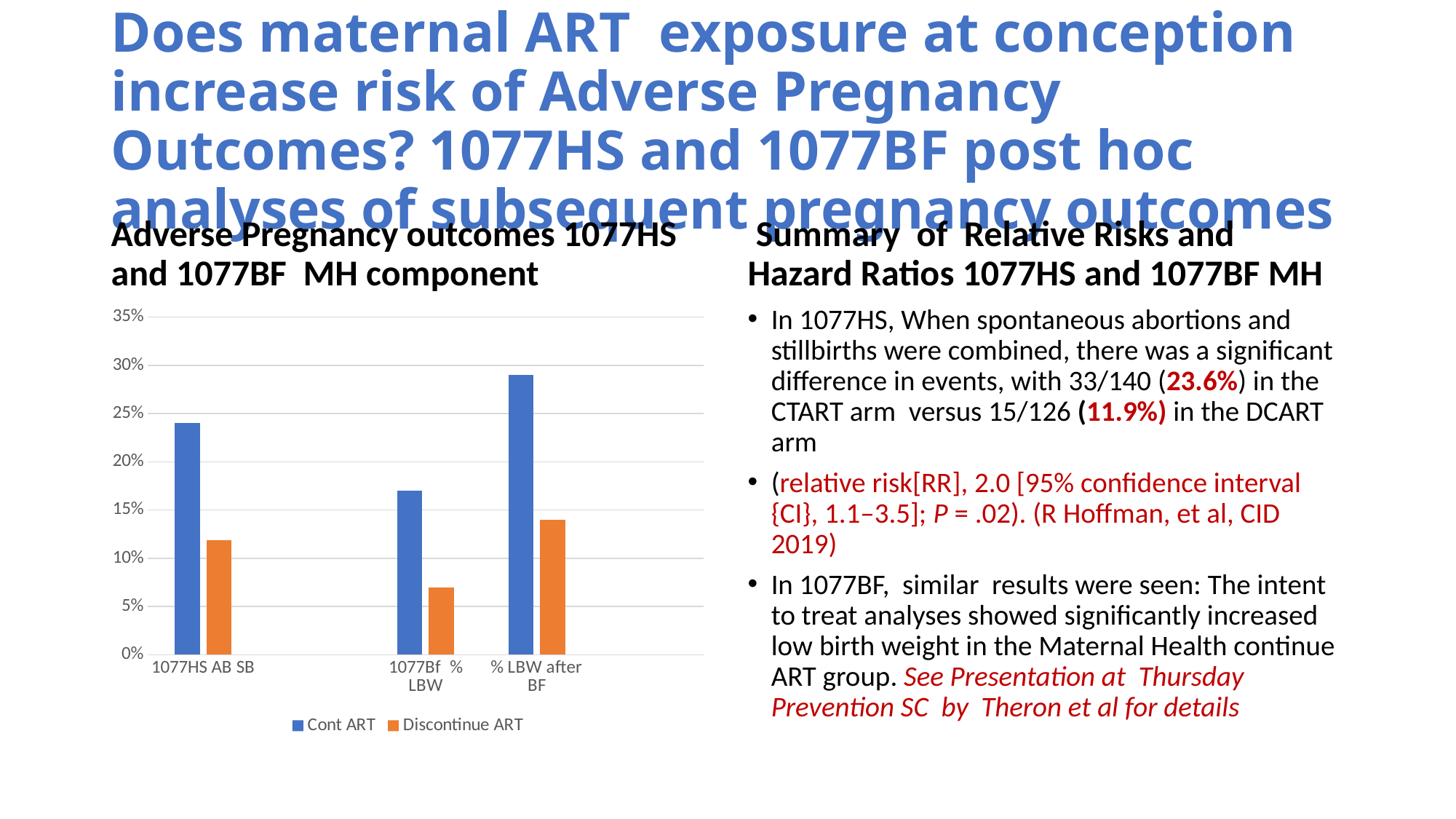
What are the two series named in the chart legend? Cont ART and Discontinue ART What is the title of the chart? Adverse Pregnancy outcomes 1077HS and 1077BF MH component How many series does the chart legend list? 2 Is the Cont ART value for % LBW after BF greater or less than 25%? greater How many categories are shown on the x axis of the chart? 3 For % LBW after BF, which is larger: Cont ART or Discontinue ART? Cont ART Is the Cont ART value for 1077HS AB SB greater or less than 20%? greater What kind of chart is shown on the slide? Bar chart For which category is the Discontinue ART bar the lowest? 1077Bf % LBW For 1077HS AB SB, which is larger: Cont ART or Discontinue ART? Cont ART For which category is the Cont ART bar the highest? % LBW after BF Is the Discontinue ART value for 1077Bf % LBW greater or less than 10%? less